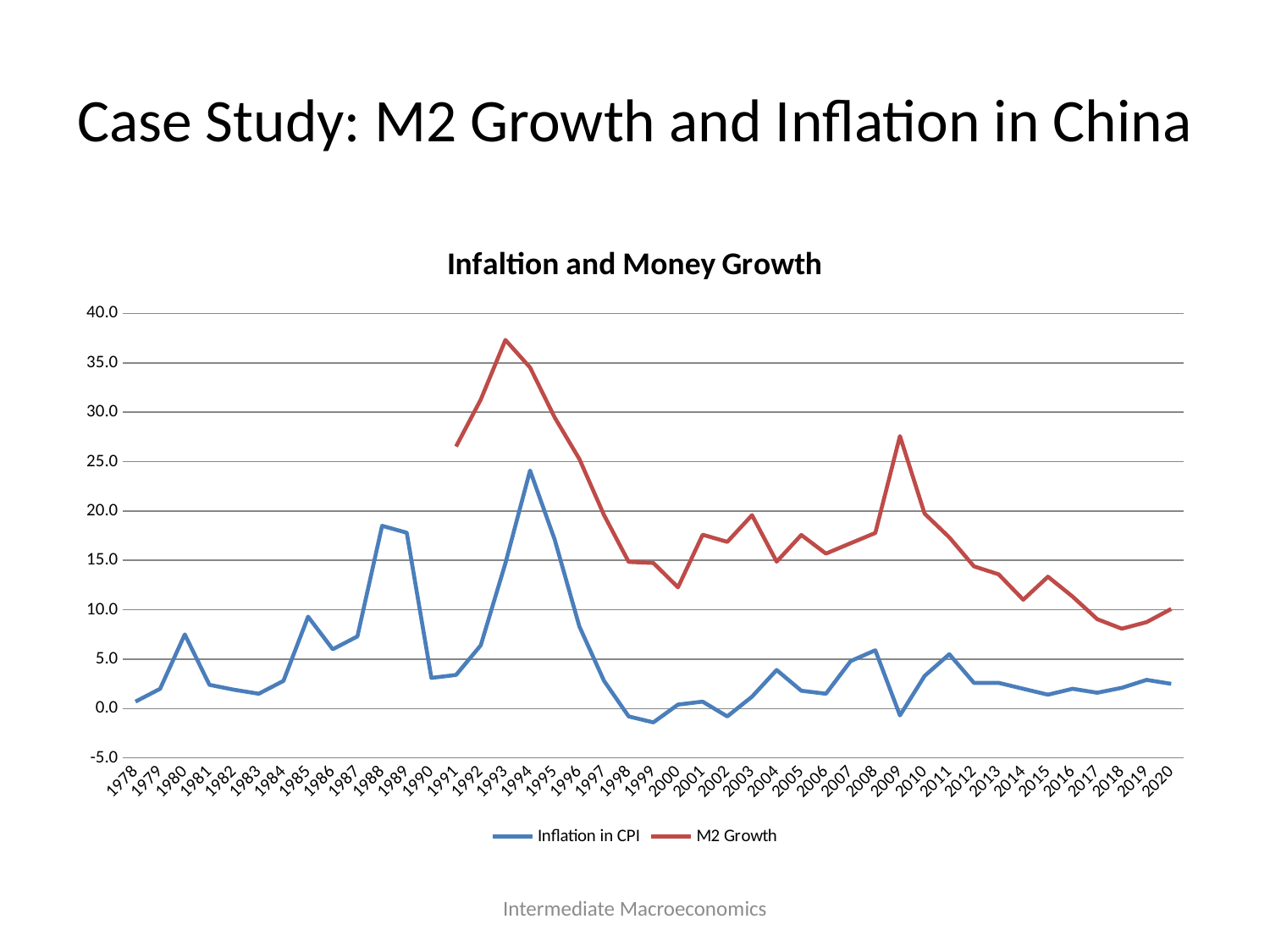
How many years are shown on the x axis? 43 Is the value for M2 Growth in 2009 greater or less than 25.0? greater Is the value for Inflation in CPI in 1994 greater or less than 20.0? greater What kind of chart is shown on the slide? Line chart In which year does Inflation in CPI reach its highest value? 1994 Is the value for M2 Growth in 1993 greater or less than 35.0? greater How many series does the legend list? 2 What is the title of the chart? Infaltion and Money Growth Which is larger: M2 Growth in 1993 or Inflation in CPI in 1994? M2 Growth in 1993 Does M2 Growth rise or fall from 2009 to 2018? Fall In which year does M2 Growth reach its highest value? 1993